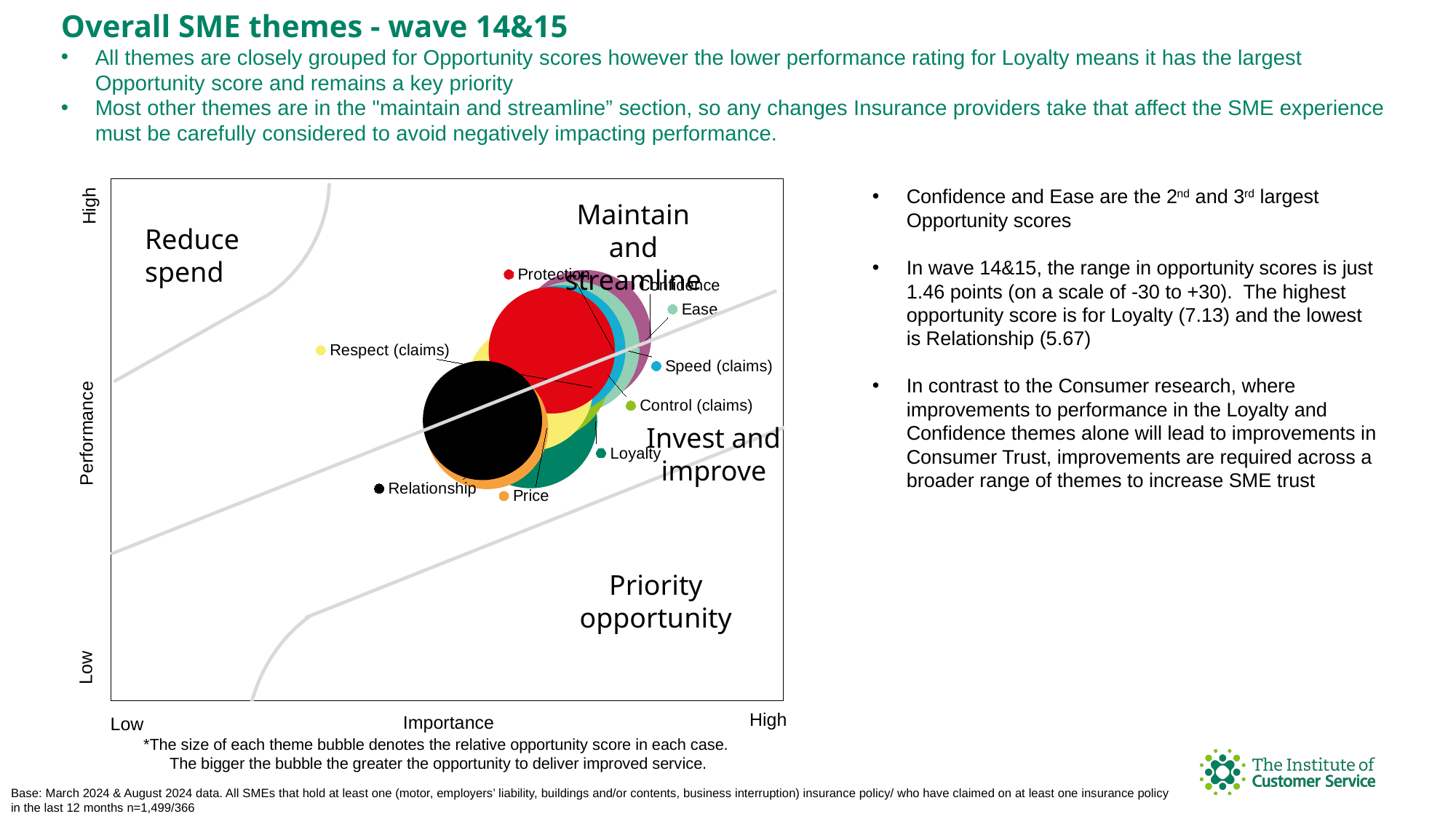
Which theme has the lowest opportunity score in wave 14&15? Relationship Which theme is plotted with higher Performance, Ease or Loyalty? Ease What is the range in opportunity scores across the themes in wave 14&15? 1.46 points What is the label of the horizontal axis of the chart? Importance What is the opportunity score for Relationship? 5.67 What is the opportunity score for Loyalty? 7.13 What kind of chart is shown on the slide? Bubble chart How many themes are plotted on the chart? 9 What is the label of the vertical axis of the chart? Performance Which theme is plotted with the lowest Importance on the chart? Respect (claims) Which theme is plotted with higher Importance, Speed (claims) or Respect (claims)? Speed (claims) Which theme has the highest opportunity score in wave 14&15? Loyalty